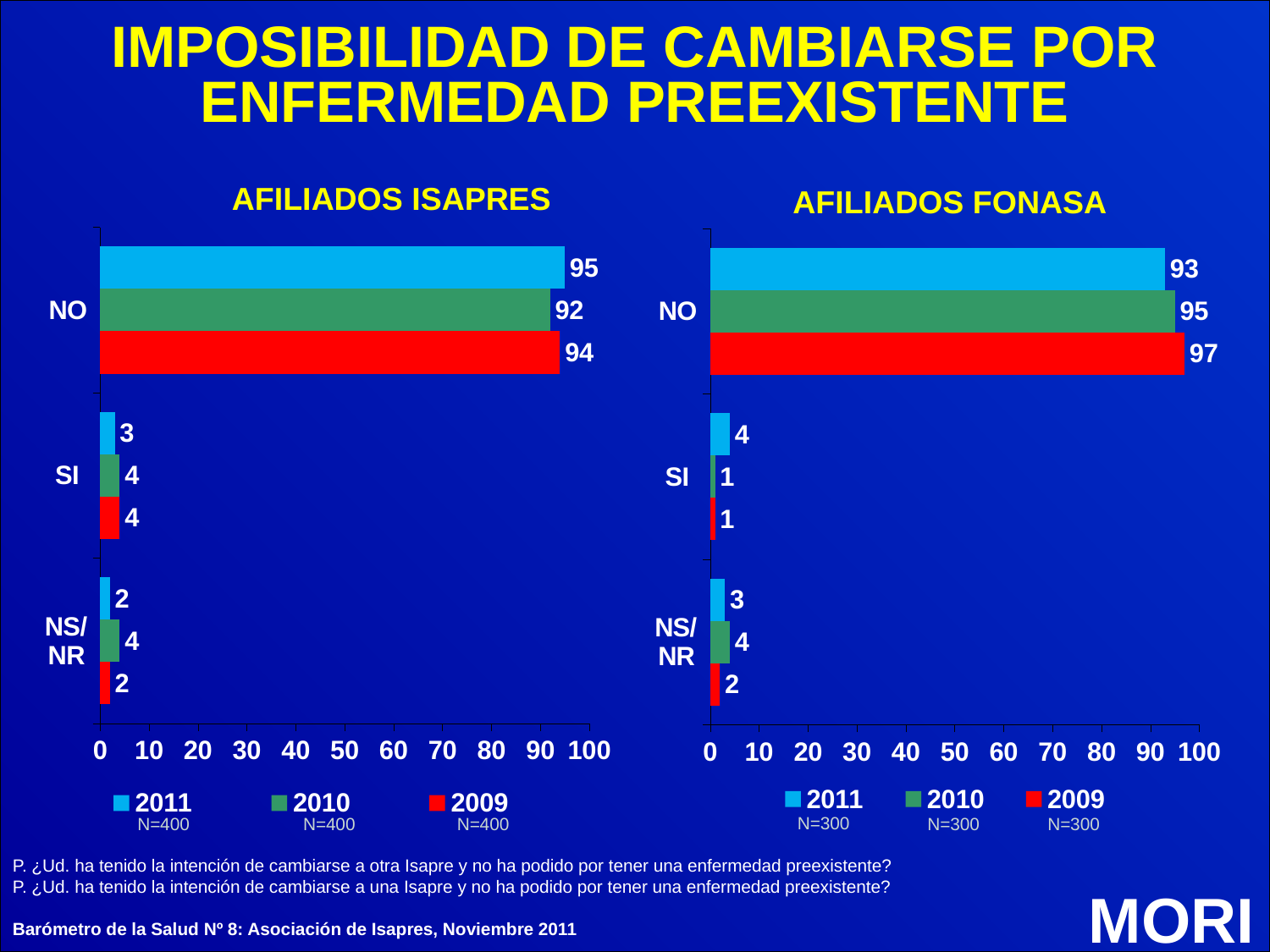
In the AFILIADOS ISAPRES chart, what is the difference between the NO values for 2011 and 2010? 3 In the AFILIADOS FONASA chart, what is the value for NS/NR in 2010? 4 In the AFILIADOS ISAPRES chart, which year has the lowest value for NO? 2010 In the AFILIADOS FONASA chart, which is larger: the SI value for 2011 or for 2010? 2011 How many series does the legend of the AFILIADOS FONASA chart list? 3 In the AFILIADOS FONASA chart, which year has the highest value for NO? 2009 In the AFILIADOS FONASA chart, is the value for NO in 2011 greater or less than 90? greater In the AFILIADOS FONASA chart, what is the value for NO in 2009? 97 In the AFILIADOS ISAPRES chart, what is the value for SI in 2010? 4 How many categories are shown on the y axis of the AFILIADOS ISAPRES chart? 3 In the AFILIADOS ISAPRES chart, what is the value for NO in 2011? 95 What kind of chart is the AFILIADOS ISAPRES chart? Bar chart